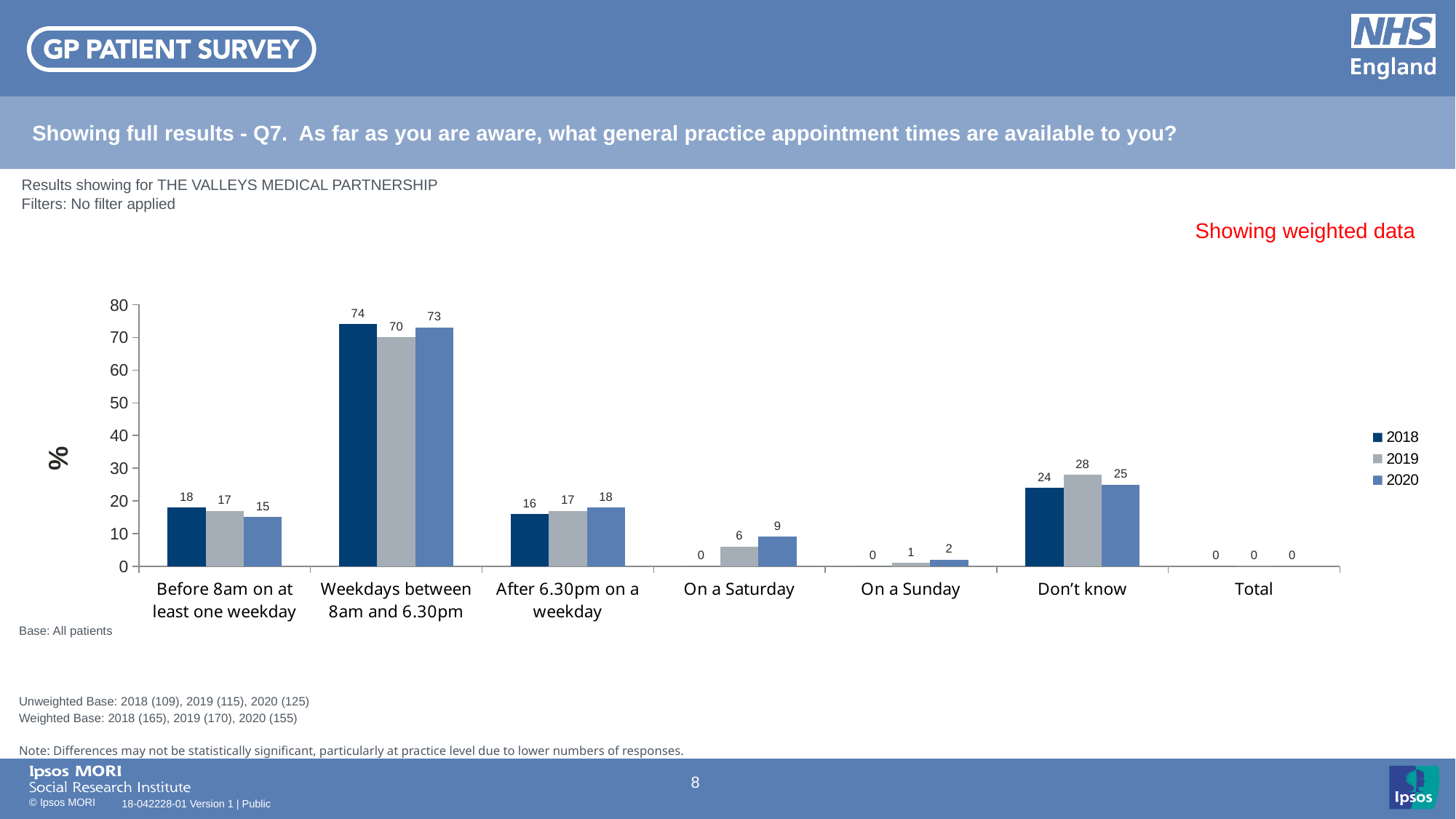
How many series does the legend list? 3 What is the 2020 value for 'On a Saturday'? 9 What is the 2019 value for 'Don't know'? 28 How many categories are shown on the x axis? 7 What is the difference between the 2018 and 2019 values for 'Weekdays between 8am and 6.30pm'? 4 What is the 2020 value for 'Before 8am on at least one weekday'? 15 Which is larger for 'After 6.30pm on a weekday': the 2018 value or the 2020 value? 2020 What is the 2019 value for 'On a Sunday'? 1 Which category has the highest 2020 value? Weekdays between 8am and 6.30pm What is the 2018 value for 'Weekdays between 8am and 6.30pm'? 74 Do the values for 'On a Saturday' rise or fall from 2018 to 2020? Rise What kind of chart is shown on the slide? Bar chart